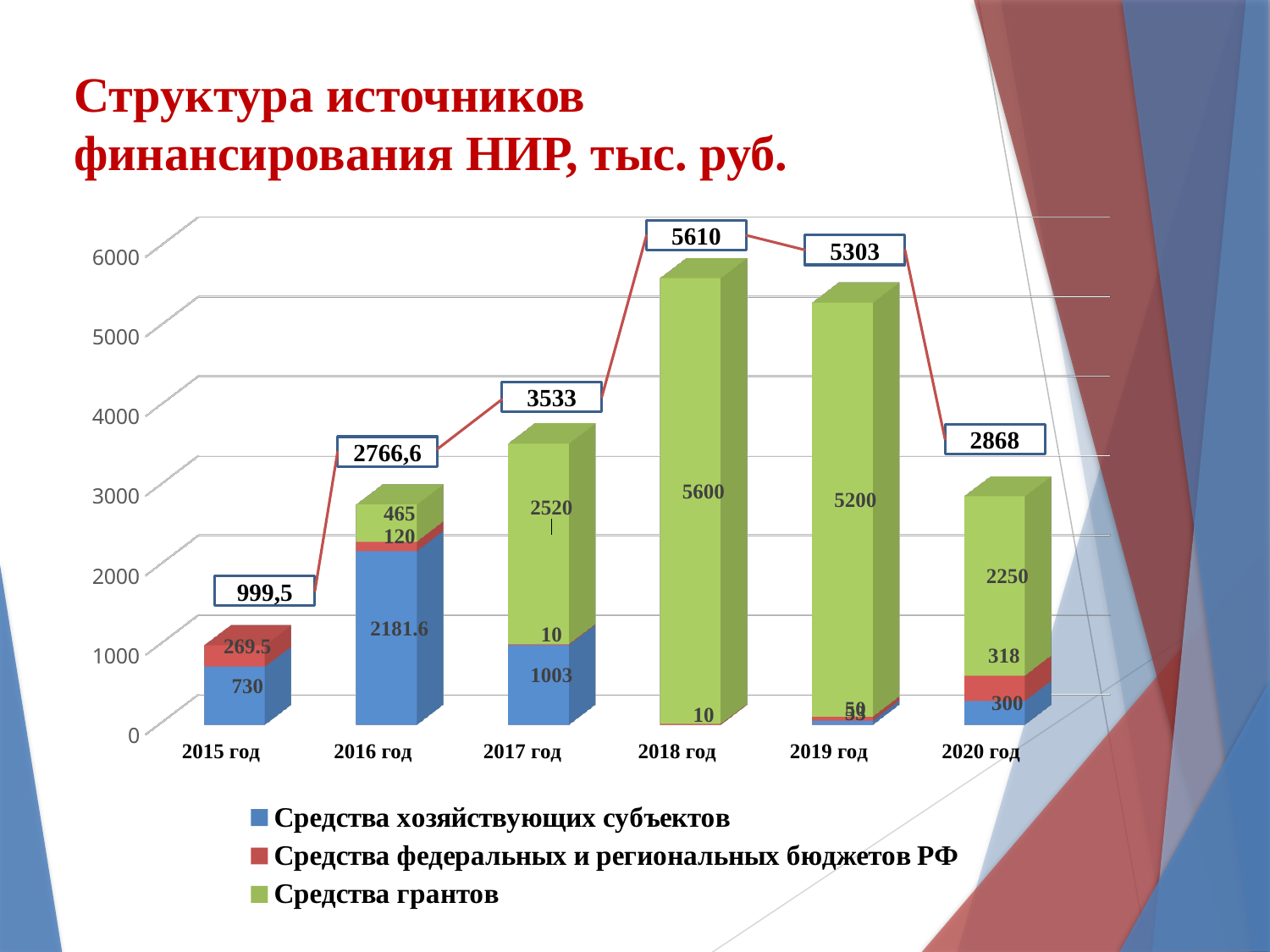
Which year has the highest total? 2018 год What is the total labelled above the bar for 2019 год? 5303 Which year has the larger value of Средства грантов, 2017 год or 2020 год? 2017 год What is the difference between Средства грантов in 2018 год and 2019 год? 400 How many series does the legend list? 3 How many years are shown on the x axis? 6 What is the value of Средства грантов for 2018 год? 5600 What is the value of Средства федеральных и региональных бюджетов РФ for 2020 год? 318 What kind of chart is shown on the slide? Stacked bar chart Do the totals rise or fall from 2015 год to 2018 год? Rise What is the value of Средства хозяйствующих субъектов for 2016 год? 2181.6 Which year has the lowest total? 2015 год